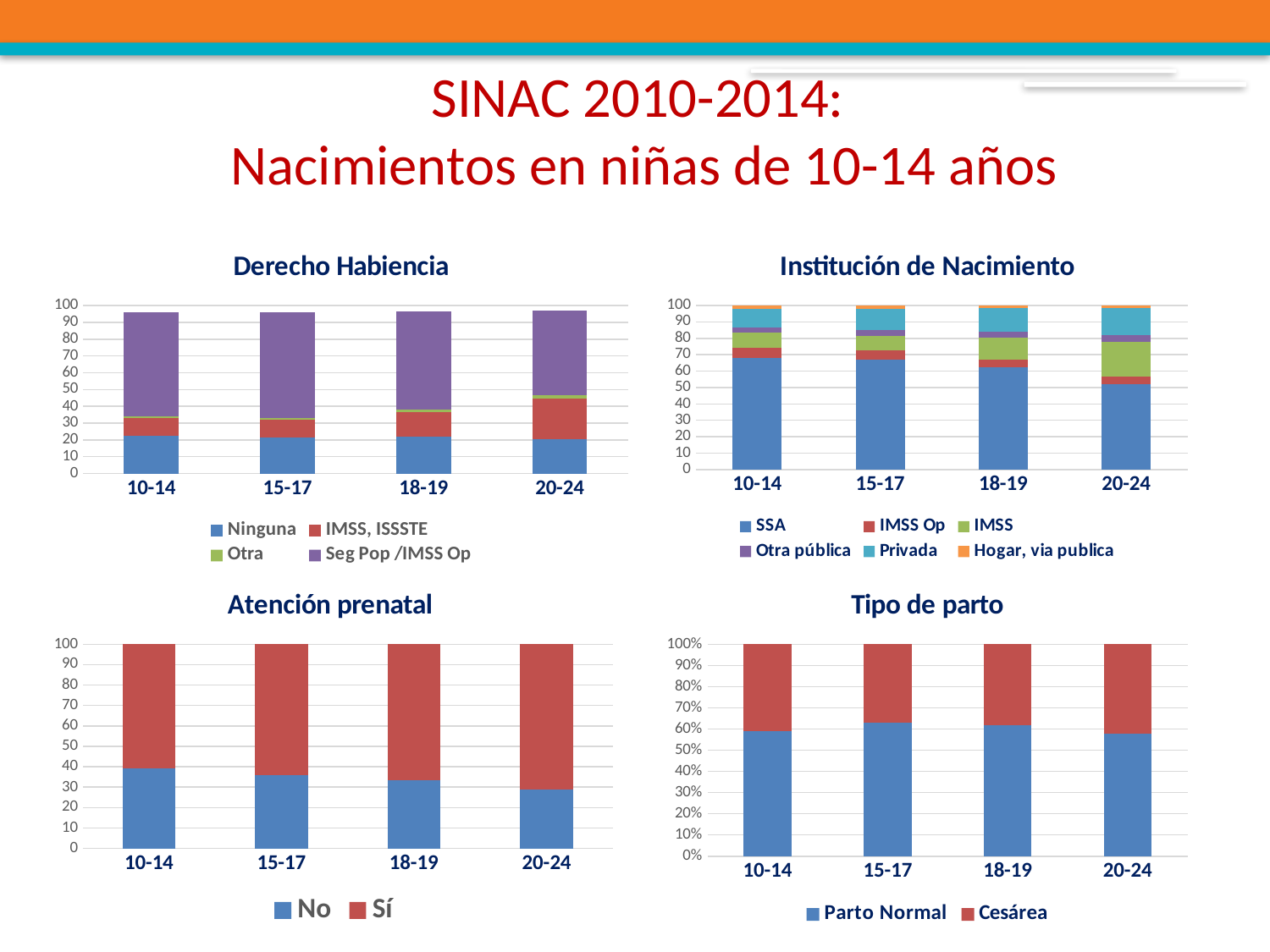
In the 'Derecho Habiencia' chart, how many series does the legend list? 4 In the 'Tipo de parto' chart, which two series does the legend list? Parto Normal and Cesárea In the 'Institución de Nacimiento' chart, how many series does the legend list? 6 How many charts are shown on the slide? 4 In the 'Atención prenatal' chart, is the 'No' value for 20-24 greater or less than 40? less In the 'Derecho Habiencia' chart, is the 'Ninguna' value for 10-14 greater or less than 30? less In the 'Institución de Nacimiento' chart, which age group has the larger 'SSA' value, 10-14 or 20-24? 10-14 In the 'Atención prenatal' chart, how many age groups are shown on the x axis? 4 In the 'Tipo de parto' chart, is the 'Parto Normal' value for 10-14 greater or less than 50%? greater In the 'Derecho Habiencia' chart, what kind of chart is used? stacked bar chart In the 'Institución de Nacimiento' chart, does the 'SSA' value rise or fall from 10-14 to 20-24? fall